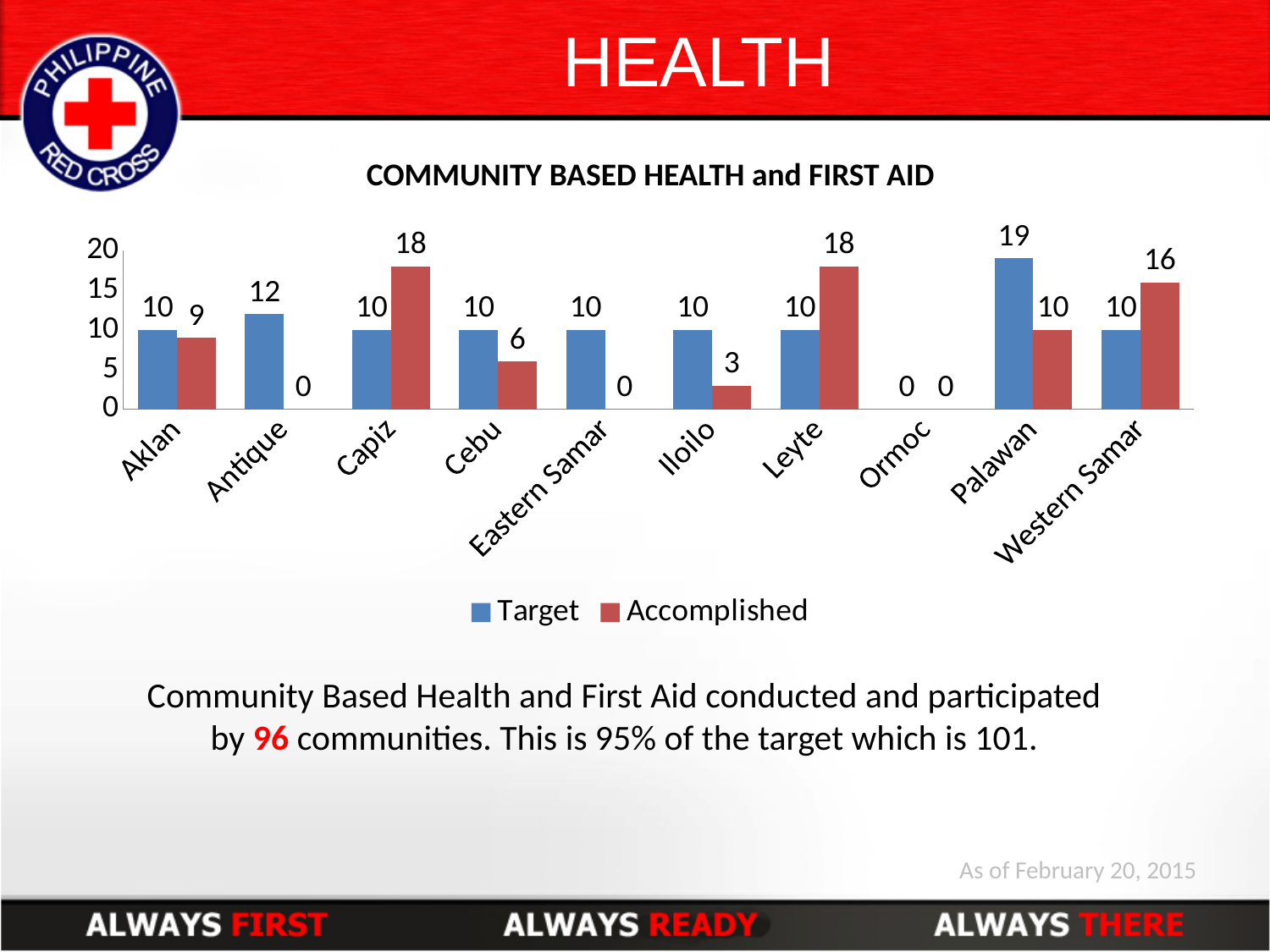
Which category has the highest Target value? Palawan What is the Accomplished value for Cebu? 6 Which category has the lowest Target value? Ormoc What type of chart is shown? Bar chart How many series does the legend list? 2 What is the Accomplished value for Western Samar? 16 What is the difference between the Target and Accomplished values for Palawan? 9 How many categories are shown on the x axis? 10 What is the Accomplished value for Iloilo? 3 What is the Target value for Palawan? 19 What is the difference between the Accomplished and Target values for Capiz? 8 Which is larger for Leyte, the Target or the Accomplished value? Accomplished